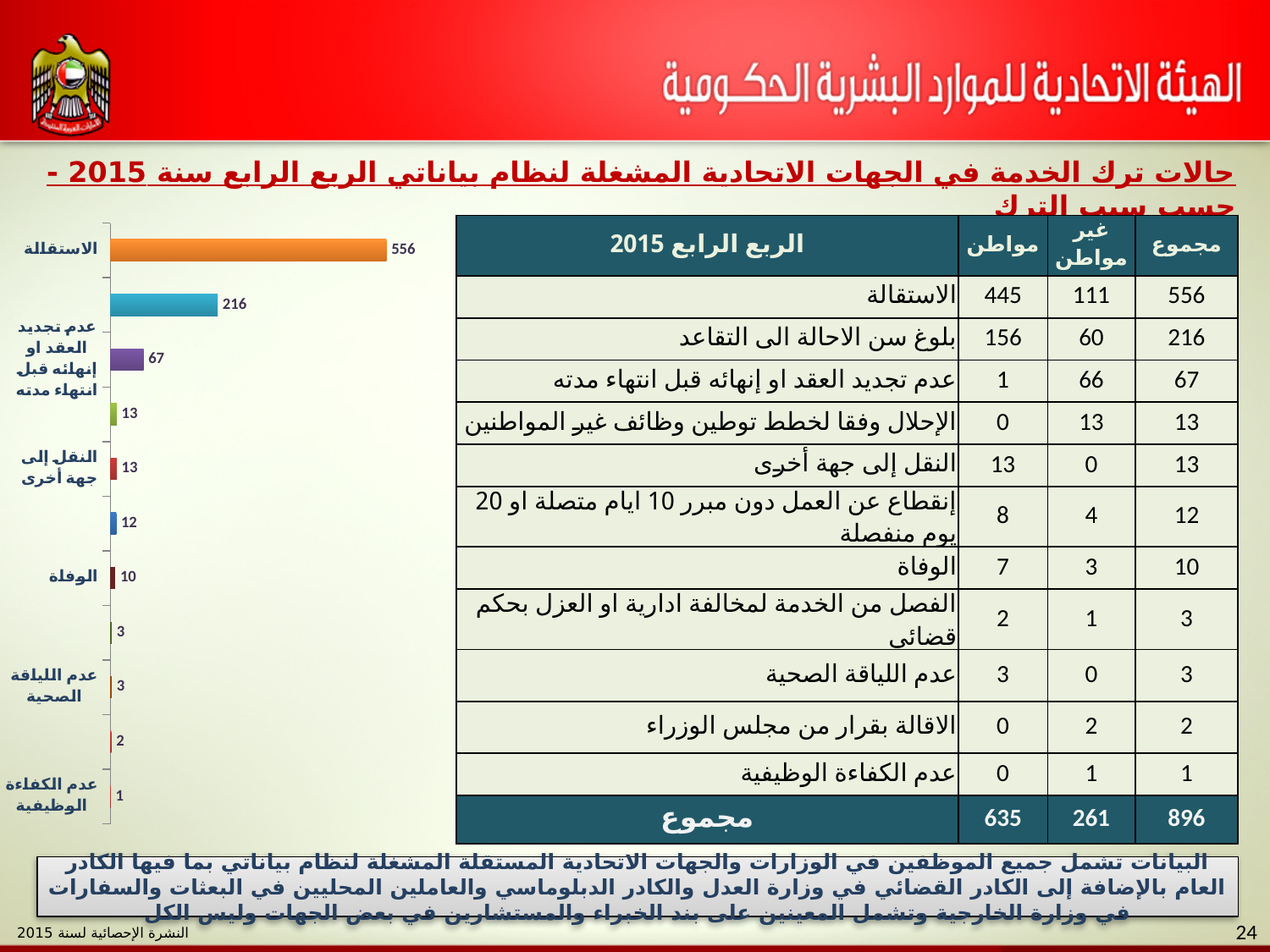
In the bar chart, what is the value for الوفاة? 10 In the bar chart, what is the value for عدم الكفاءة الوظيفية? 1 In the bar chart, what is the value for عدم تجديد العقد او إنهائه قبل انتهاء مدته? 67 In the bar chart, what is the value for النقل إلى جهة أخرى? 13 What type of chart is shown on the left of the slide? bar chart In the bar chart, which is larger: the value for الوفاة or the value for عدم اللياقة الصحية? الوفاة Which category has the highest value in the bar chart? الاستقالة Which category has the lowest value in the bar chart? عدم الكفاءة الوظيفية How many bars are plotted in the bar chart? 11 In the bar chart, what is the value for عدم اللياقة الصحية? 3 In the bar chart, what is the value for الاستقالة? 556 In the bar chart, what is the difference between the values for الاستقالة and عدم تجديد العقد او إنهائه قبل انتهاء مدته? 489